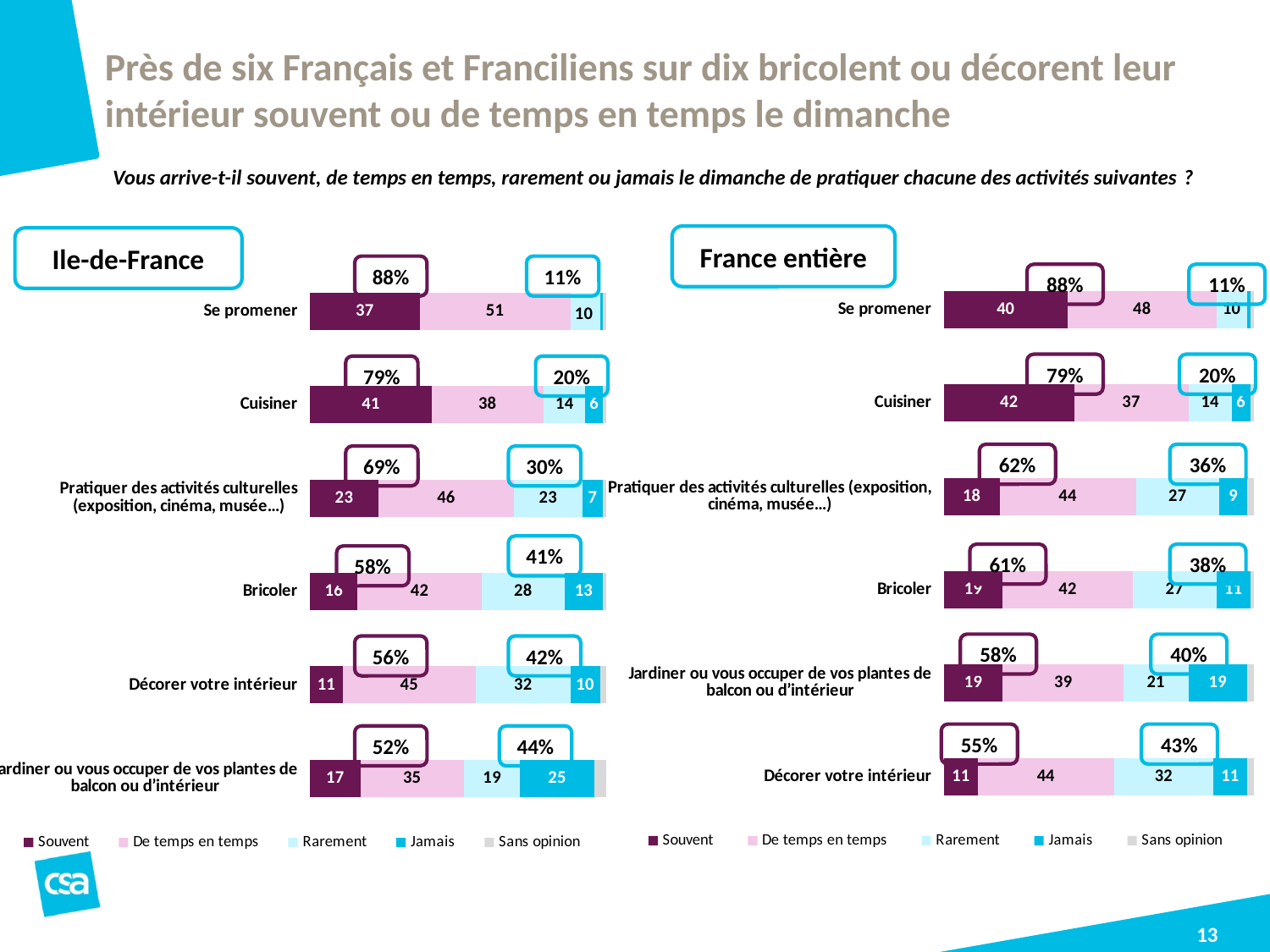
In the France entière chart, what is the 'Rarement' value for Décorer votre intérieur? 32 In the France entière chart, which is larger: the 'Jamais' value for Jardiner ou vous occuper de vos plantes de balcon ou d'intérieur or the 'Jamais' value for Bricoler? Jardiner ou vous occuper de vos plantes de balcon ou d'intérieur In the France entière chart, what combined percentage is shown in the left callout for Bricoler? 61% How many activities are shown in the Ile-de-France chart? 6 In the Ile-de-France chart, what is the difference between the 'De temps en temps' values for Se promener and Cuisiner? 13 In the Ile-de-France chart, what is the 'Jamais' value for Jardiner ou vous occuper de vos plantes de balcon ou d'intérieur? 25 In the France entière chart, what is the 'De temps en temps' value for Se promener? 48 In the Ile-de-France chart, which activity has the highest 'Souvent' value? Cuisiner What kind of chart is the Ile-de-France chart? Stacked bar chart In the France entière chart, which activity has the lowest 'Souvent' value? Décorer votre intérieur In the Ile-de-France chart, what is the 'Souvent' value for Cuisiner? 41 How many series does the legend of the France entière chart list? 5